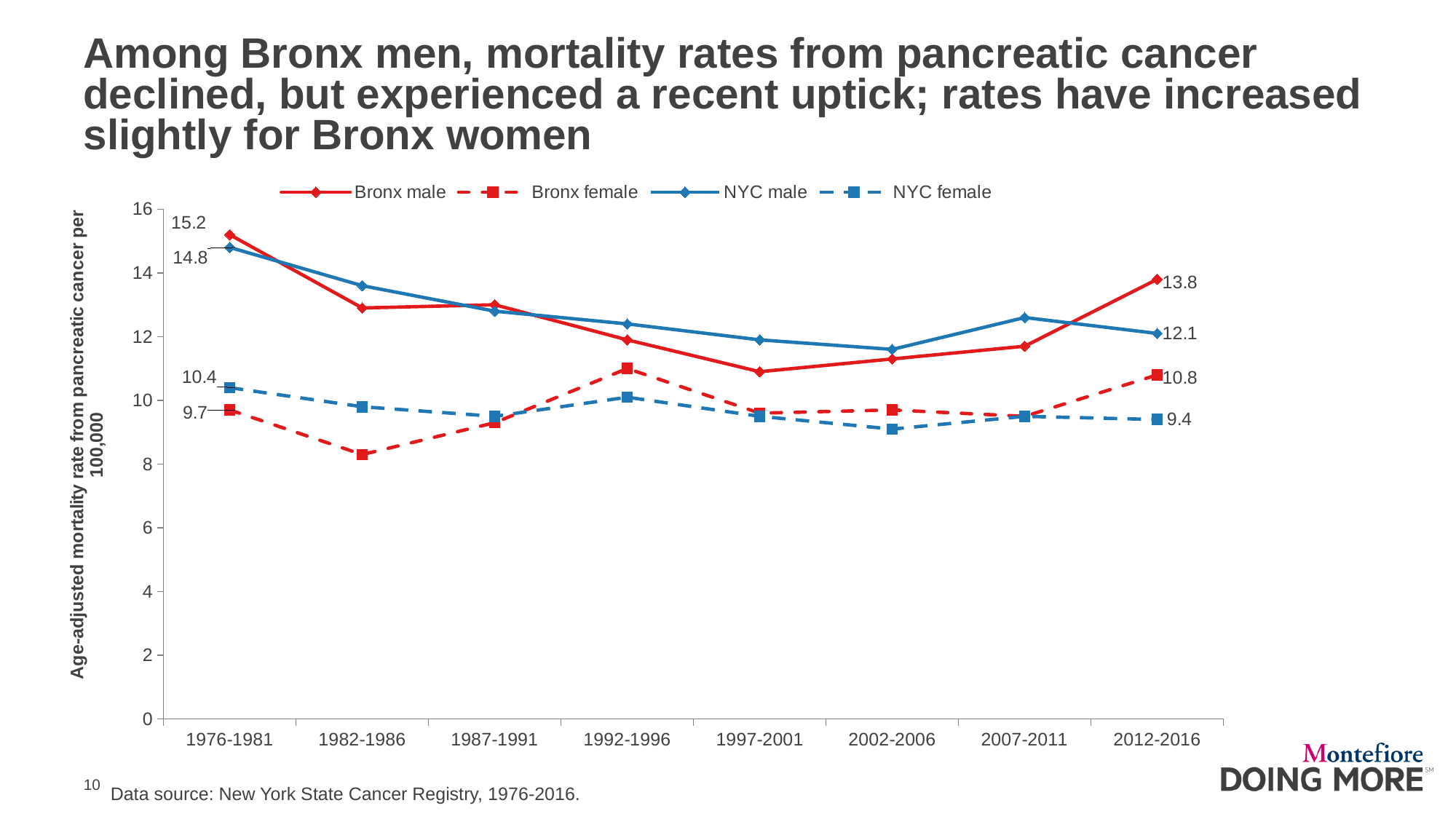
Is the Bronx female value for 1982-1986 greater or less than 10? less What is the NYC female mortality rate for 1976-1981? 10.4 What is the Bronx male mortality rate for 1976-1981? 15.2 What is the difference between the Bronx male rate in 1976-1981 and in 2012-2016? 1.4 Does the NYC male series rise or fall from 1976-1981 to 2002-2006? fall What kind of chart is shown on the slide? line chart Which series is drawn with a solid red line? Bronx male Which is larger in 2012-2016, the Bronx male rate or the NYC male rate? Bronx male How many time periods are shown on the x axis? 8 What is the NYC male mortality rate for 2012-2016? 12.1 How many series does the legend list? 4 What is the Bronx female mortality rate for 2012-2016? 10.8